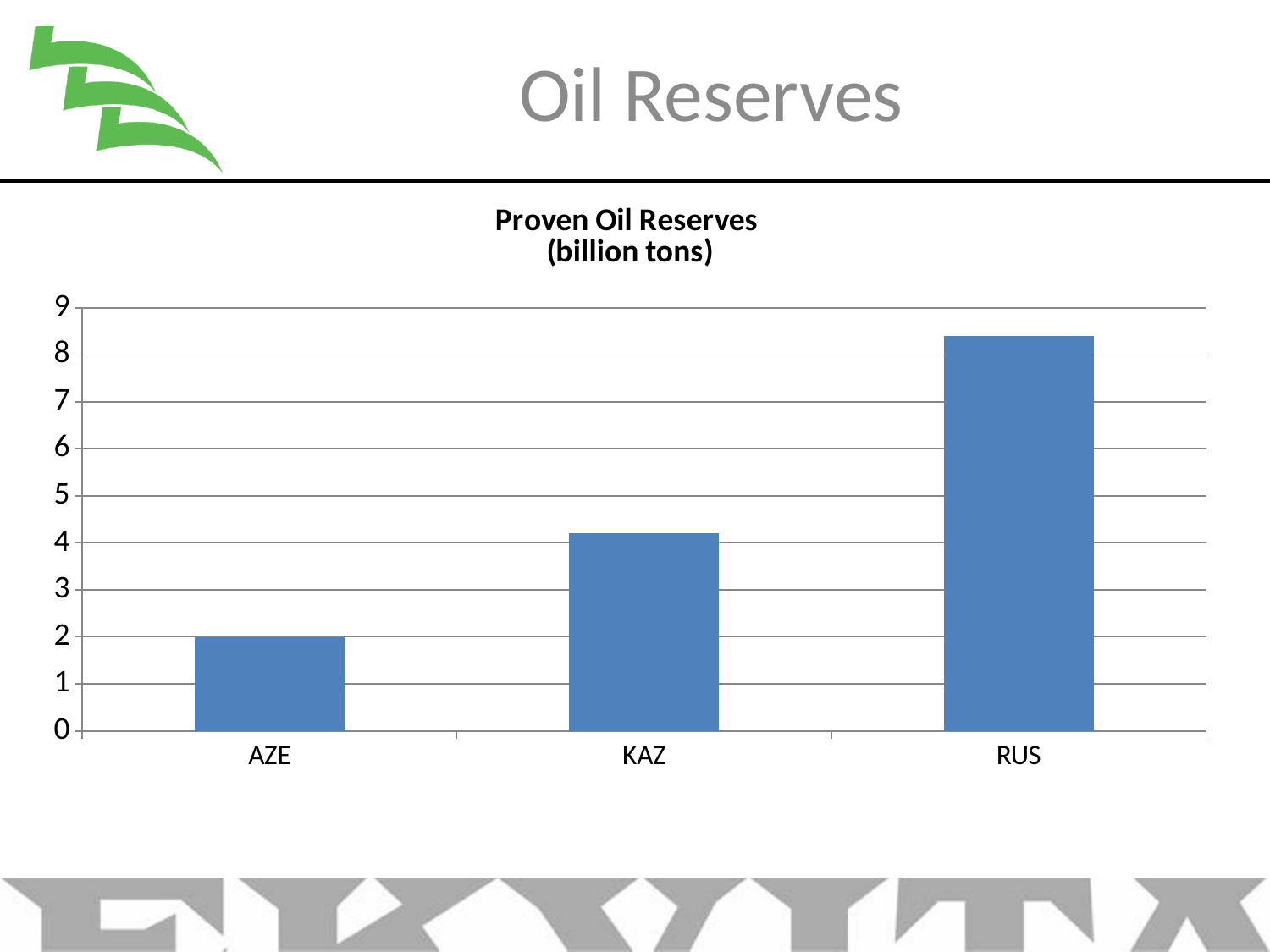
Do the values rise or fall moving from AZE to RUS along the x axis? rise What is the title of the chart? Proven Oil Reserves (billion tons) Is the value for KAZ greater or less than 4? greater Is the value for RUS greater or less than 8? greater Which country has the lowest proven oil reserves in the chart? AZE Is the value for RUS greater or less than 9? less How many countries are shown on the x axis of the chart? 3 Which has larger proven oil reserves, KAZ or RUS? RUS Which country has the highest proven oil reserves in the chart? RUS What kind of chart is shown on the slide? bar chart